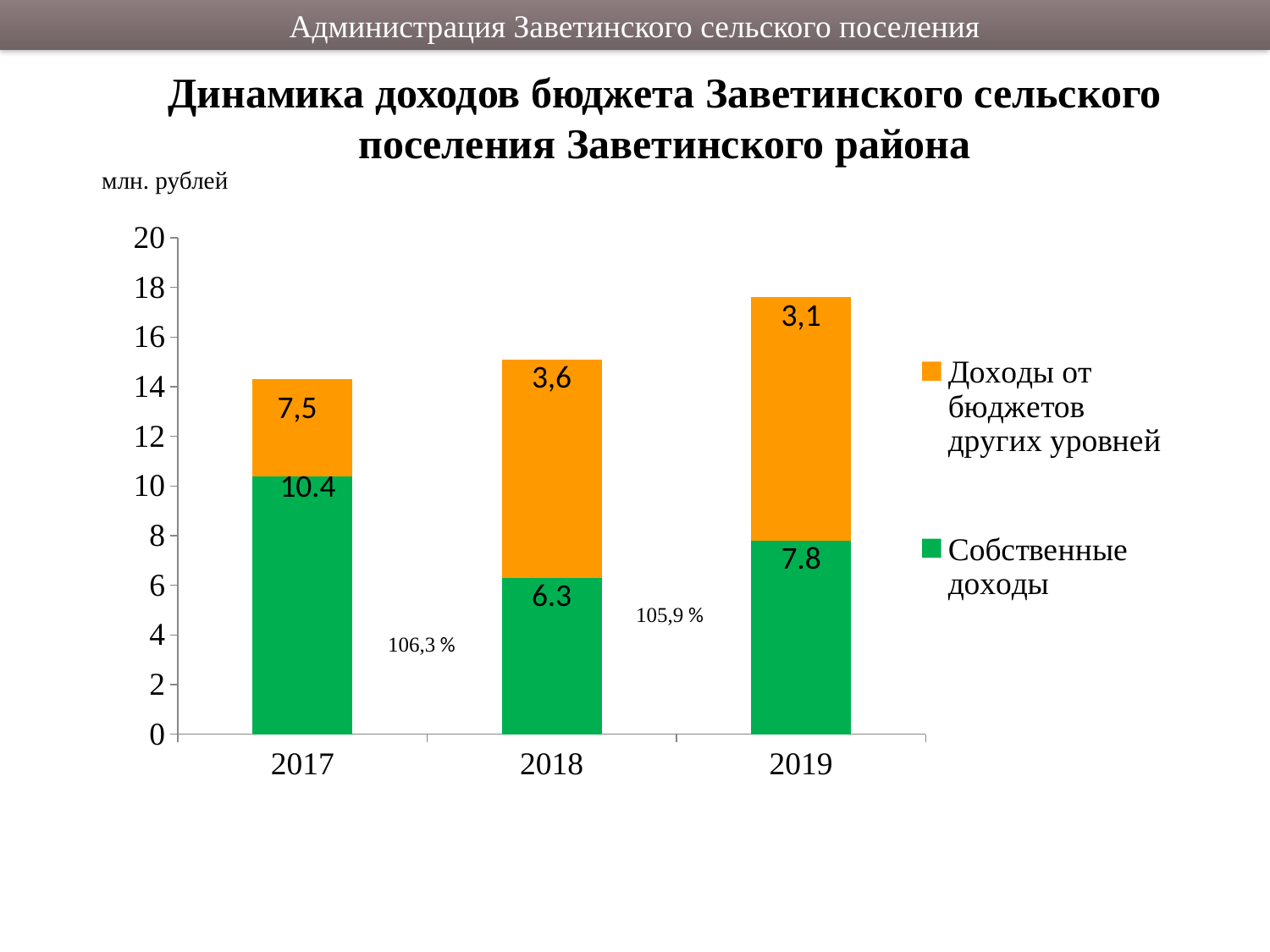
How many years are shown on the x axis of the chart? 3 What is the value labelled for Доходы от бюджетов других уровней in 2018? 3,6 What is the value of Собственные доходы for 2019? 7.8 What is the difference between Собственные доходы in 2017 and in 2018? 4.1 In which year is Собственные доходы the highest? 2017 What is the value of Собственные доходы for 2017? 10.4 What is the value labelled for Доходы от бюджетов других уровней in 2019? 3,1 What is the value of Собственные доходы for 2018? 6.3 How many series does the chart legend list? 2 Is the total height of the stacked bar for 2019 greater or less than 16? greater What type of chart is shown on the slide? bar chart In which year is Собственные доходы the lowest? 2018